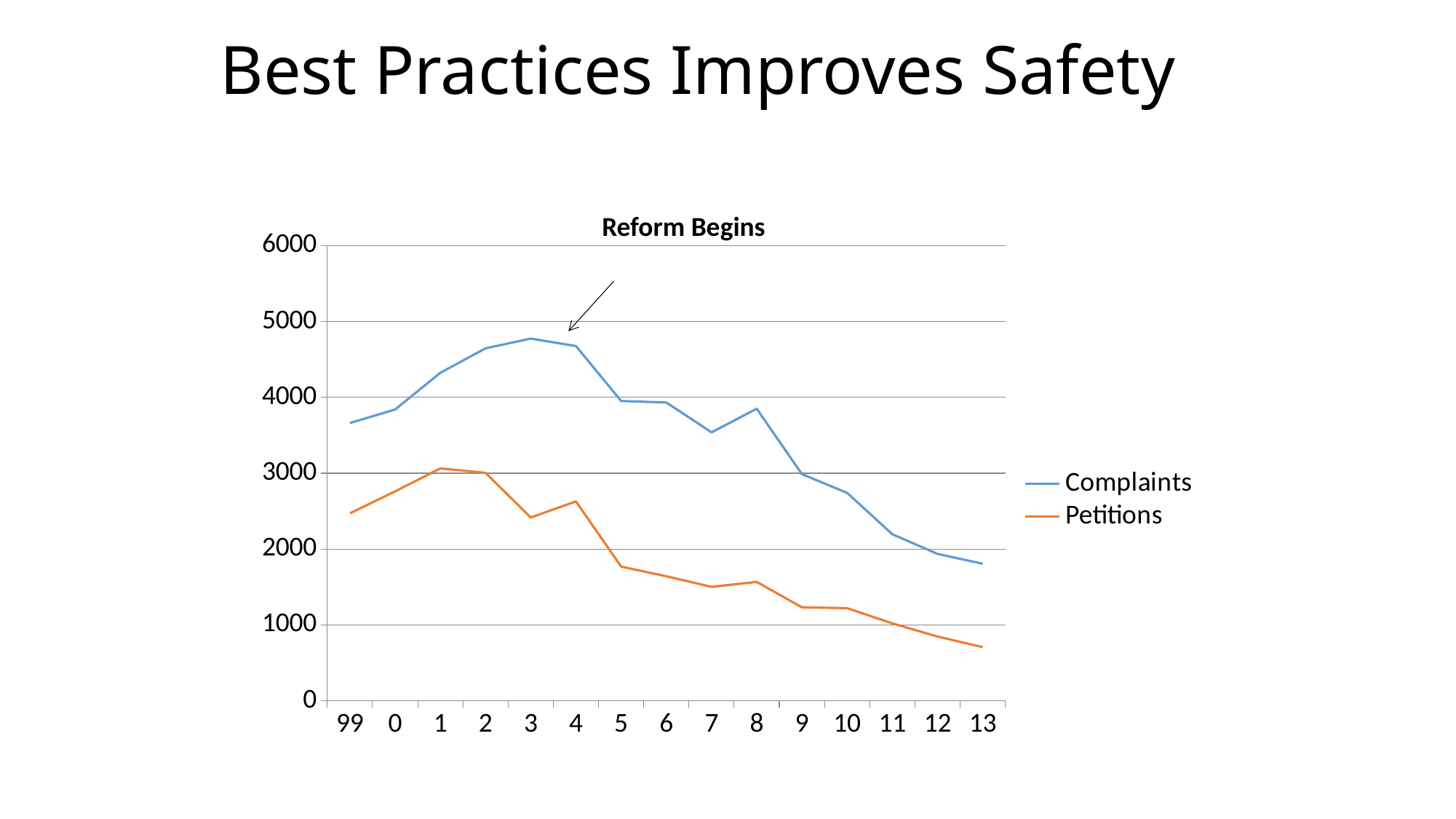
What kind of chart is shown on the slide? line chart How many series does the legend list? 2 Is the value for Petitions in year 13 greater or less than 1000? less Is the value for Complaints in year 13 greater or less than 2000? less What colour is the Petitions line? orange How many points are plotted along the x axis for each series? 15 In which year does the Complaints line reach its highest value? 3 Which series has the higher value in year 8, Complaints or Petitions? Complaints Is the value for Complaints in year 3 greater or less than 4000? greater In which year does the Petitions line reach its lowest value? 13 Do the Complaints values rise or fall from year 4 to year 13? fall